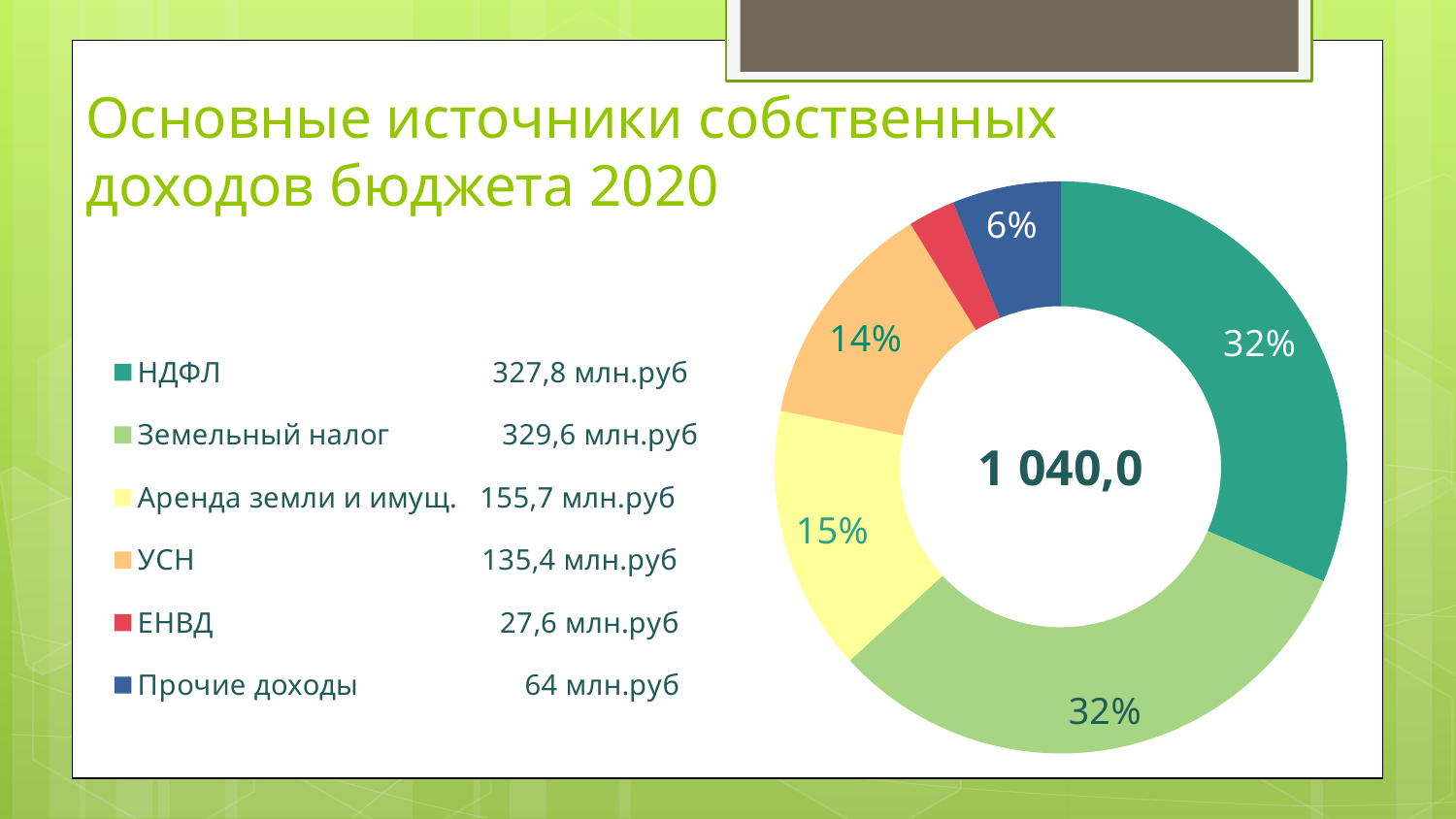
What is the value for Прочие доходы? 64 млн.руб Which is larger, Аренда земли и имущ. or УСН? Аренда земли и имущ. What is the value for НДФЛ? 327,8 млн.руб What is the value for УСН? 135,4 млн.руб How many categories does the chart show? 6 Which category has the lowest value? ЕНВД What share of the chart does Аренда земли и имущ. represent? 15% What is the difference between Земельный налог and НДФЛ? 1,8 млн.руб What share of the chart does Прочие доходы represent? 6% What kind of chart is shown on the slide? Doughnut (pie) chart What is the value for Земельный налог? 329,6 млн.руб What total value is shown in the centre of the chart? 1 040,0